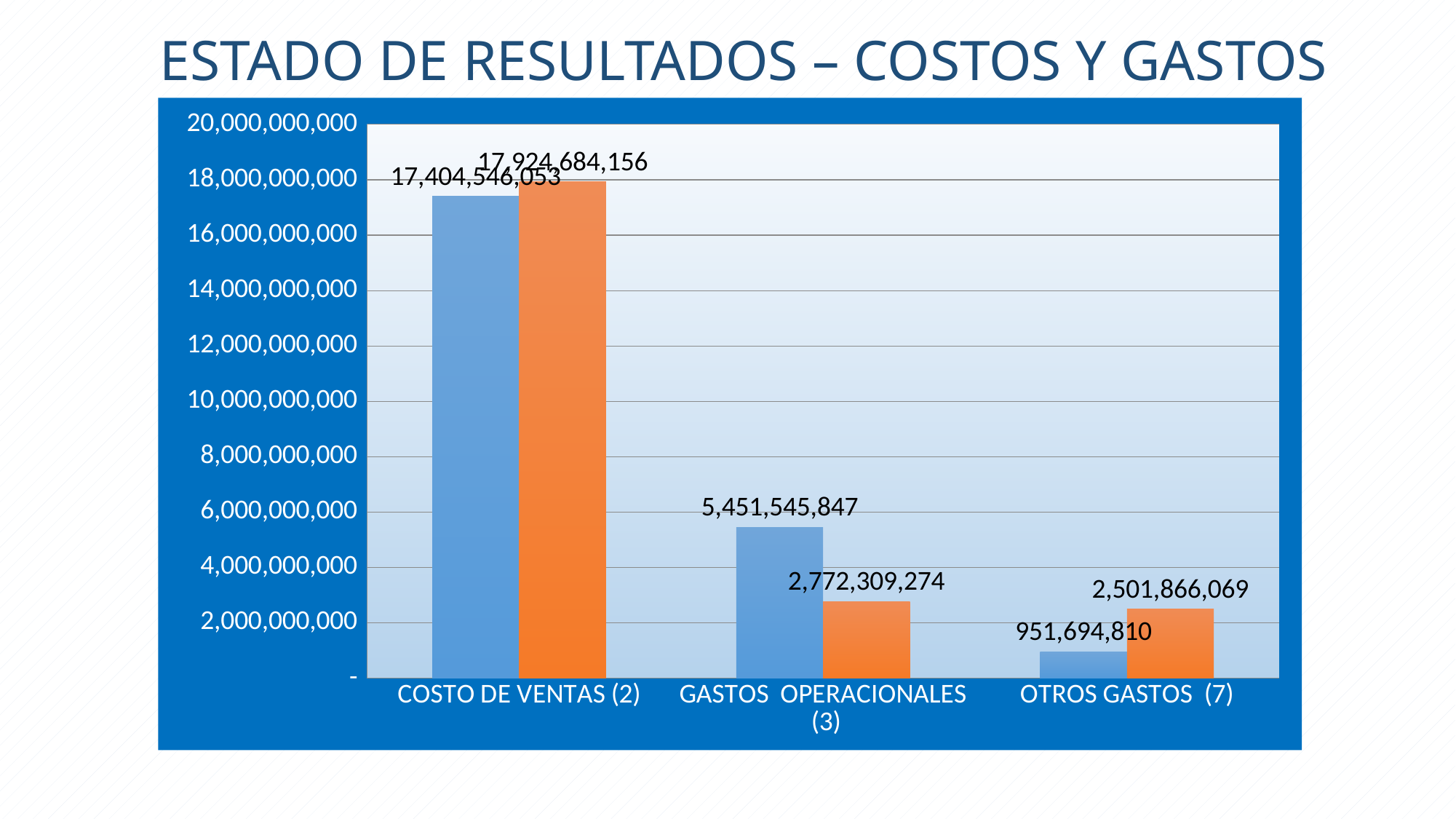
Which category has the lowest blue bar? OTROS GASTOS (7) For OTROS GASTOS (7), which bar is larger, the blue or the orange? orange Which category has the highest orange bar? COSTO DE VENTAS (2) What is the value of the orange bar for OTROS GASTOS (7)? 2,501,866,069 What is the value of the blue bar for COSTO DE VENTAS (2)? 17,404,546,053 What is the difference between the blue and orange bars for GASTOS OPERACIONALES (3)? 2,679,236,573 What is the value of the orange bar for COSTO DE VENTAS (2)? 17,924,684,156 What is the difference between the orange and blue bars for OTROS GASTOS (7)? 1,550,171,259 What is the value of the blue bar for GASTOS OPERACIONALES (3)? 5,451,545,847 Is the blue bar for GASTOS OPERACIONALES (3) greater or less than 4,000,000,000? greater What type of chart is shown on the slide? bar chart How many categories are shown on the x axis? 3